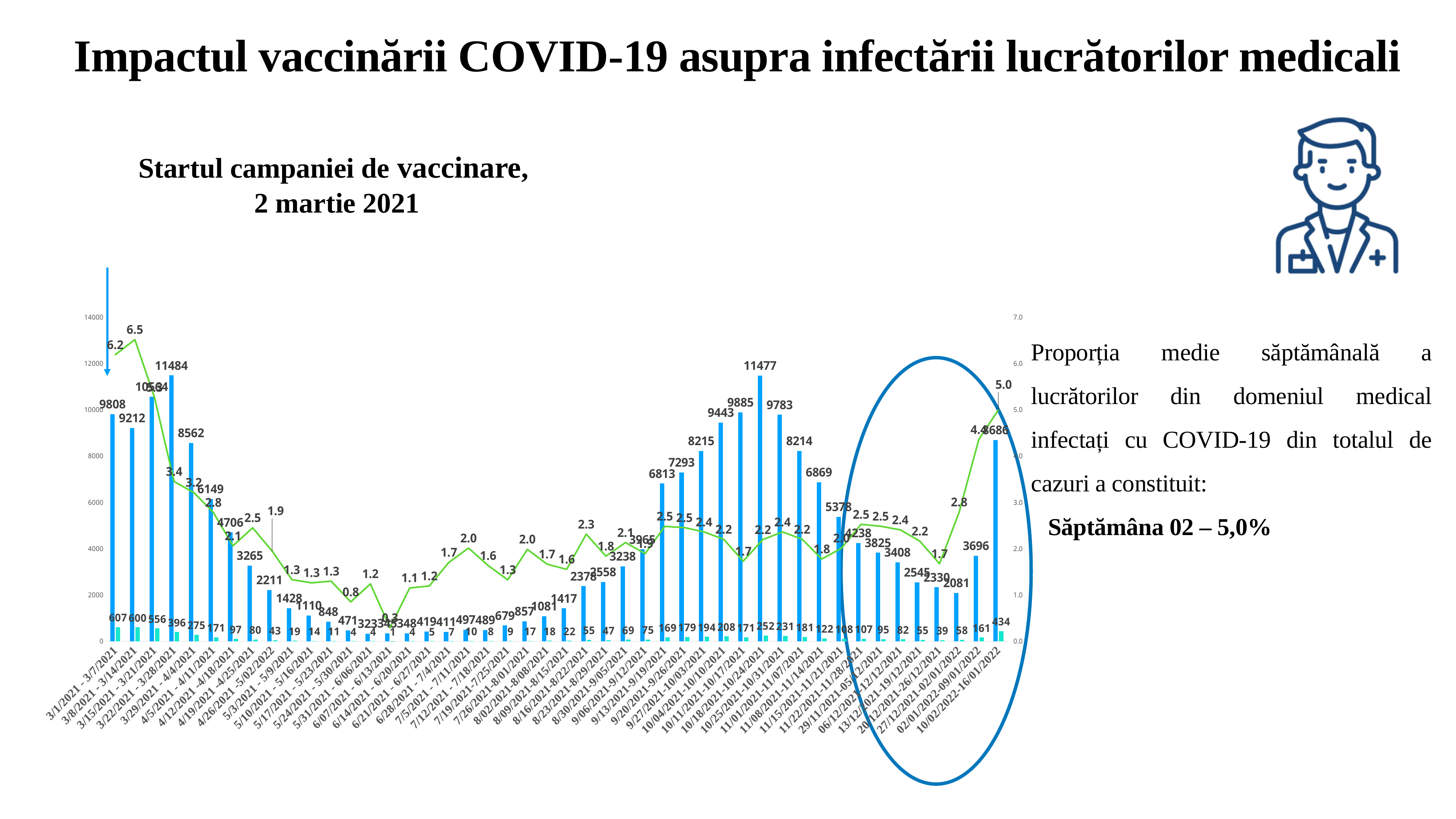
What is the difference between the blue bar for 10/18/2021 - 10/24/2021 and the blue bar for 10/11/2021 - 10/17/2021? 1592 What is the value of the tallest blue bar? 11484 What event does the blue arrow at the left of the chart mark? Startul campaniei de vaccinare, 2 martie 2021 What is the value of the blue bar for 3/22/2021 - 3/28/2021? 11484 What is the lowest value shown on the green line? 0.3 Which has the larger blue bar: 3/1/2021 - 3/7/2021 or 3/8/2021 - 3/14/2021? 3/1/2021 - 3/7/2021 What is the value of the small teal bar for 3/1/2021 - 3/7/2021? 607 Which weekly period has the tallest blue bar? 3/22/2021 - 3/28/2021 What is the green line value for the last period, 10/01/2022 - 16/01/2022? 5.0 What kind of chart is shown on the slide? Combination bar and line chart What is the green line value for 3/8/2021 - 3/14/2021? 6.5